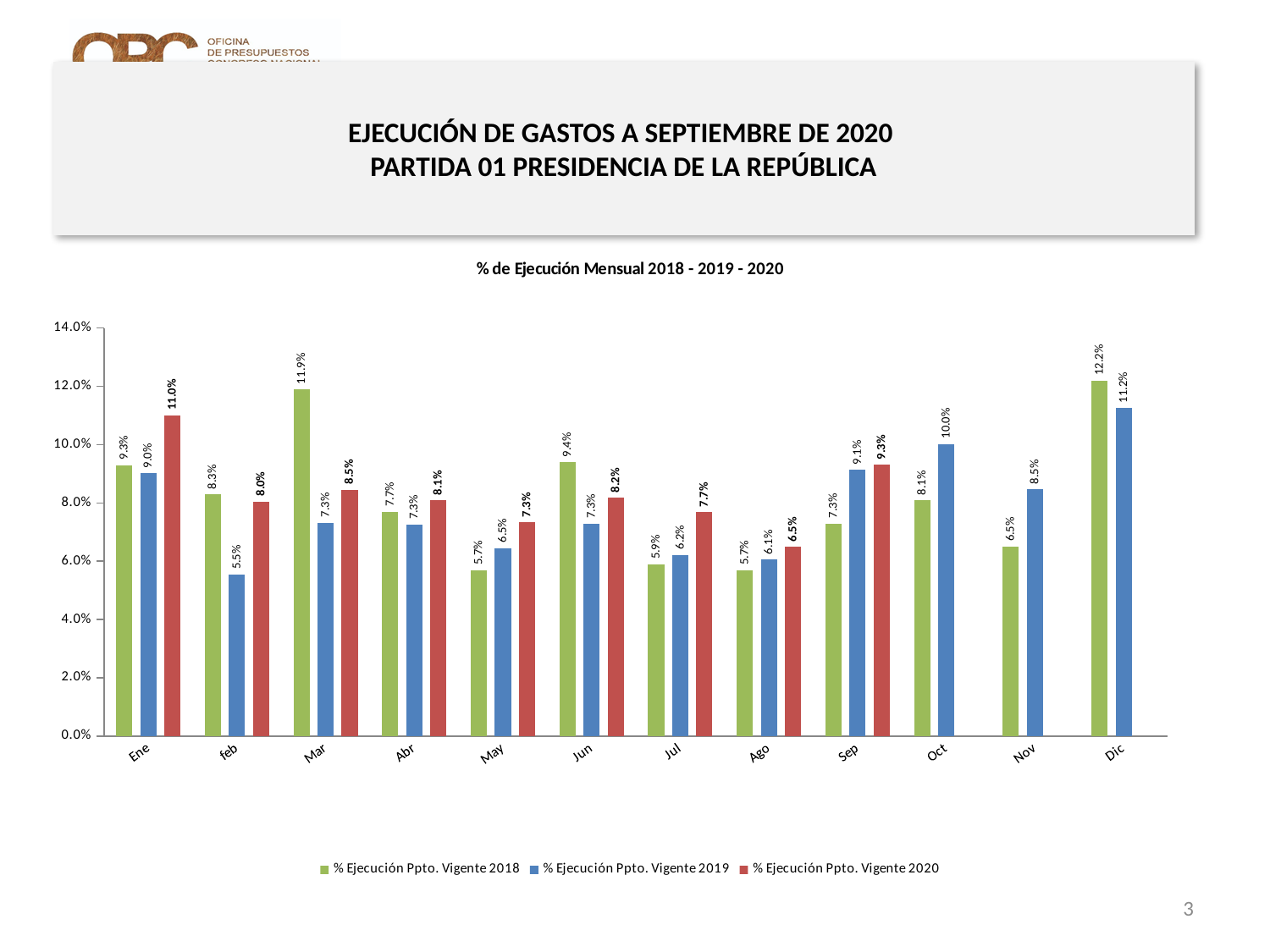
What is the title of the chart? % de Ejecución Mensual 2018 - 2019 - 2020 Which month has the highest % Ejecución Ppto. Vigente 2018 value? Dic How many series does the legend list? 3 What kind of chart is shown on the slide? Bar chart Which month has the lowest % Ejecución Ppto. Vigente 2019 value? Feb Which is larger for Sep: the 2018 value or the 2019 value? 2019 What is the difference between the 2018 and 2019 values for Mar? 4.6% What is the % Ejecución Ppto. Vigente 2018 value for Dic? 12.2% How many months are shown on the x axis? 12 Is the % Ejecución Ppto. Vigente 2019 value for Oct greater or less than 8.0%? greater What is the % Ejecución Ppto. Vigente 2019 value for Feb? 5.5% What is the % Ejecución Ppto. Vigente 2020 value for Ene? 11.0%